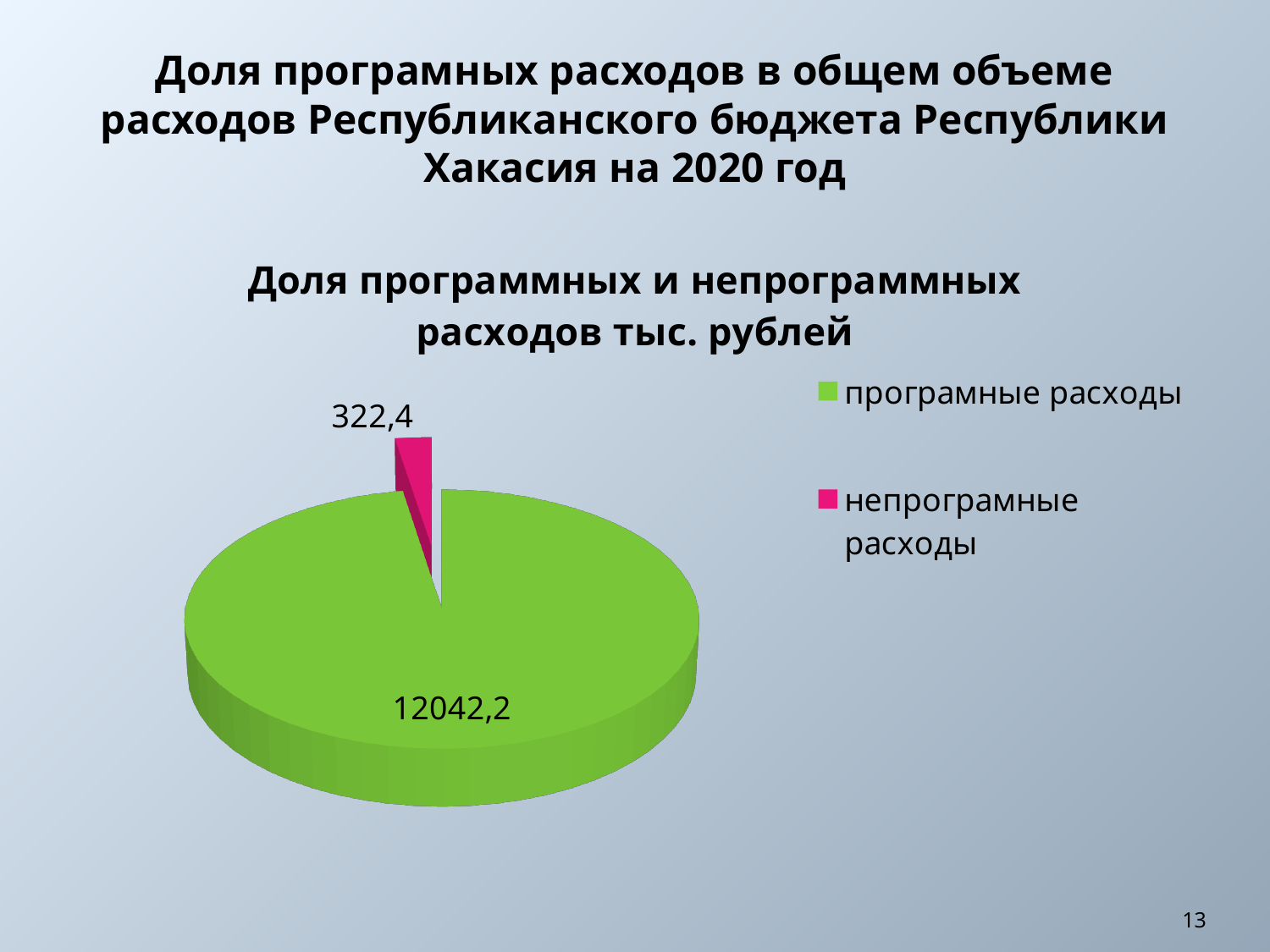
How many slices does the pie chart have? 2 Which category has the smallest slice in the pie chart? непрограмные расходы What is the value for програмные расходы in the pie chart? 12042,2 What type of chart is shown on the slide? pie chart Which category has the largest slice in the pie chart? програмные расходы What is the total of the two values shown in the pie chart? 12364,6 How many entries does the legend list? 2 What is the difference between програмные расходы and непрограмные расходы? 11719,8 What is the value for непрограмные расходы in the pie chart? 322,4 What is the title of the chart? Доля программных и непрограммных расходов тыс. рублей Which is larger, програмные расходы or непрограмные расходы? програмные расходы What colour is the slice for непрограмные расходы? pink